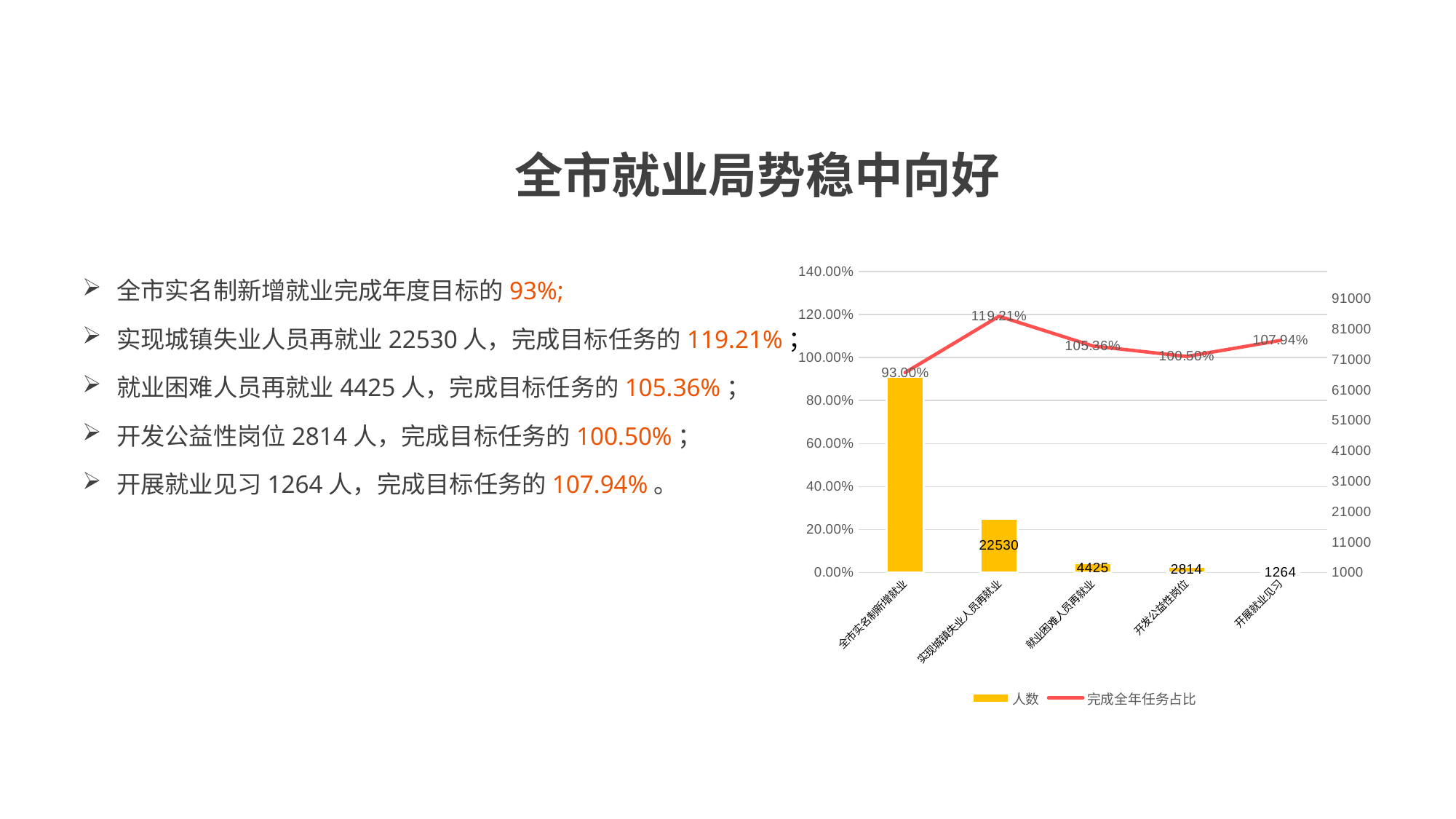
What is the 完成全年任务占比 value for 实现城镇失业人员再就业? 119.21% Which category has the highest 完成全年任务占比? 实现城镇失业人员再就业 What is the difference in 人数 between 实现城镇失业人员再就业 and 就业困难人员再就业? 18105 What is the 完成全年任务占比 value for 全市实名制新增就业? 93.00% How many categories are shown on the x axis of the chart? 5 Which category has the lowest 完成全年任务占比? 全市实名制新增就业 How many series does the chart legend list? 2 What is the 人数 value for 开展就业见习? 1264 What is the 人数 value for 就业困难人员再就业? 4425 Which has a larger 人数, 开发公益性岗位 or 开展就业见习? 开发公益性岗位 What kind of chart is shown on the slide? Combined bar and line chart What is the difference in 完成全年任务占比 between 实现城镇失业人员再就业 and 全市实名制新增就业? 26.21%